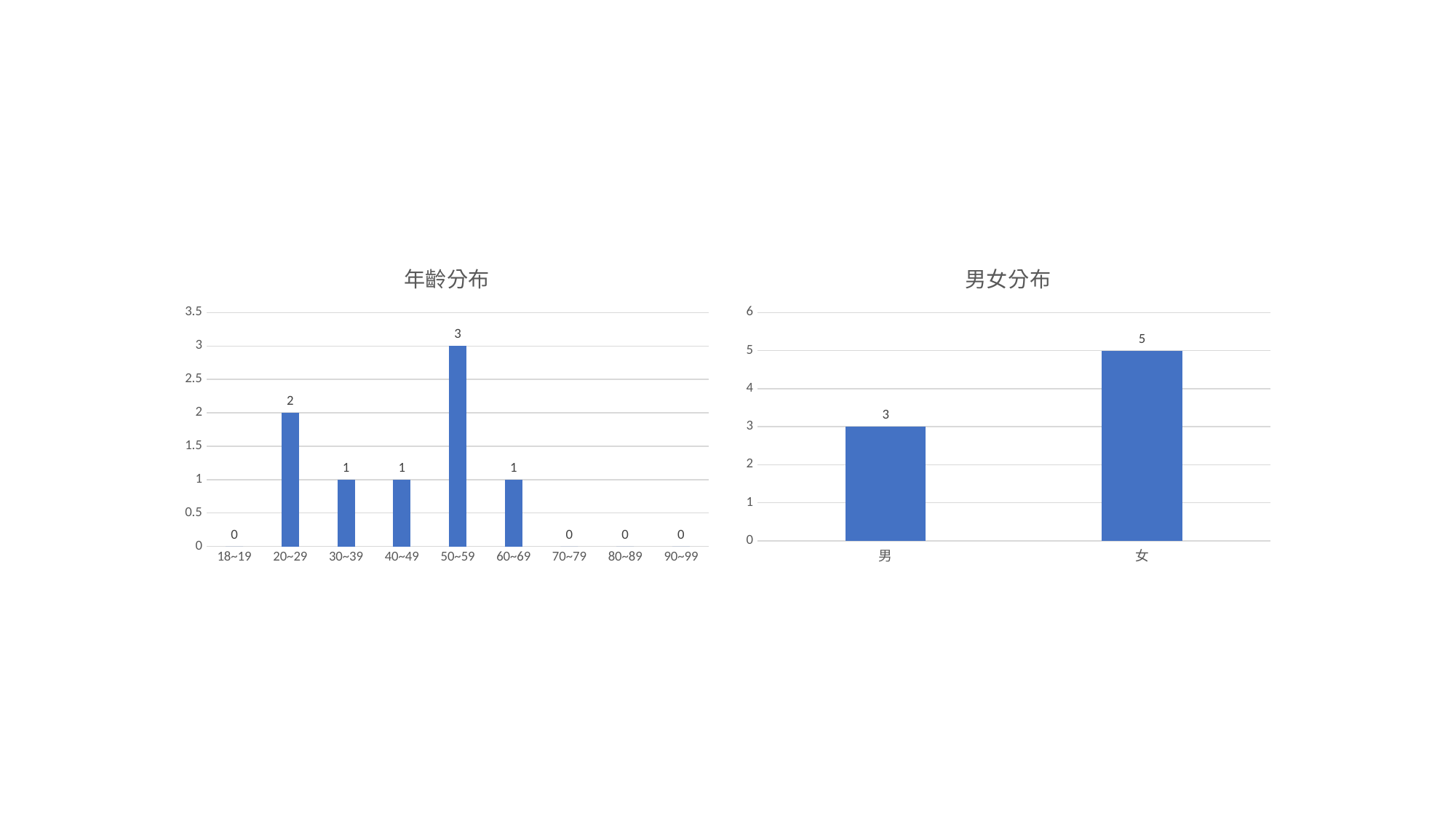
What kind of chart is the 男女分布 chart? Bar chart In the 年齢分布 chart, what is the difference between the values for 50~59 and 20~29? 1 In the 年齢分布 chart, which is larger, the value for 20~29 or the value for 60~69? 20~29 What is the title of the chart on the left side of the slide? 年齡分布 In the 男女分布 chart, what is the value for 男? 3 In the 年齢分布 chart, how many age groups have a value of 0? 4 In the 年齢分布 chart, what is the value for the 50~59 age group? 3 In the 年齢分布 chart, what is the value for the 20~29 age group? 2 In the 男女分布 chart, what is the difference between the values for 女 and 男? 2 In the 年齢分布 chart, which age group has the highest value? 50~59 In the 男女分布 chart, what is the value for 女? 5 In the 年齢分布 chart, how many age group categories are shown on the x axis? 9